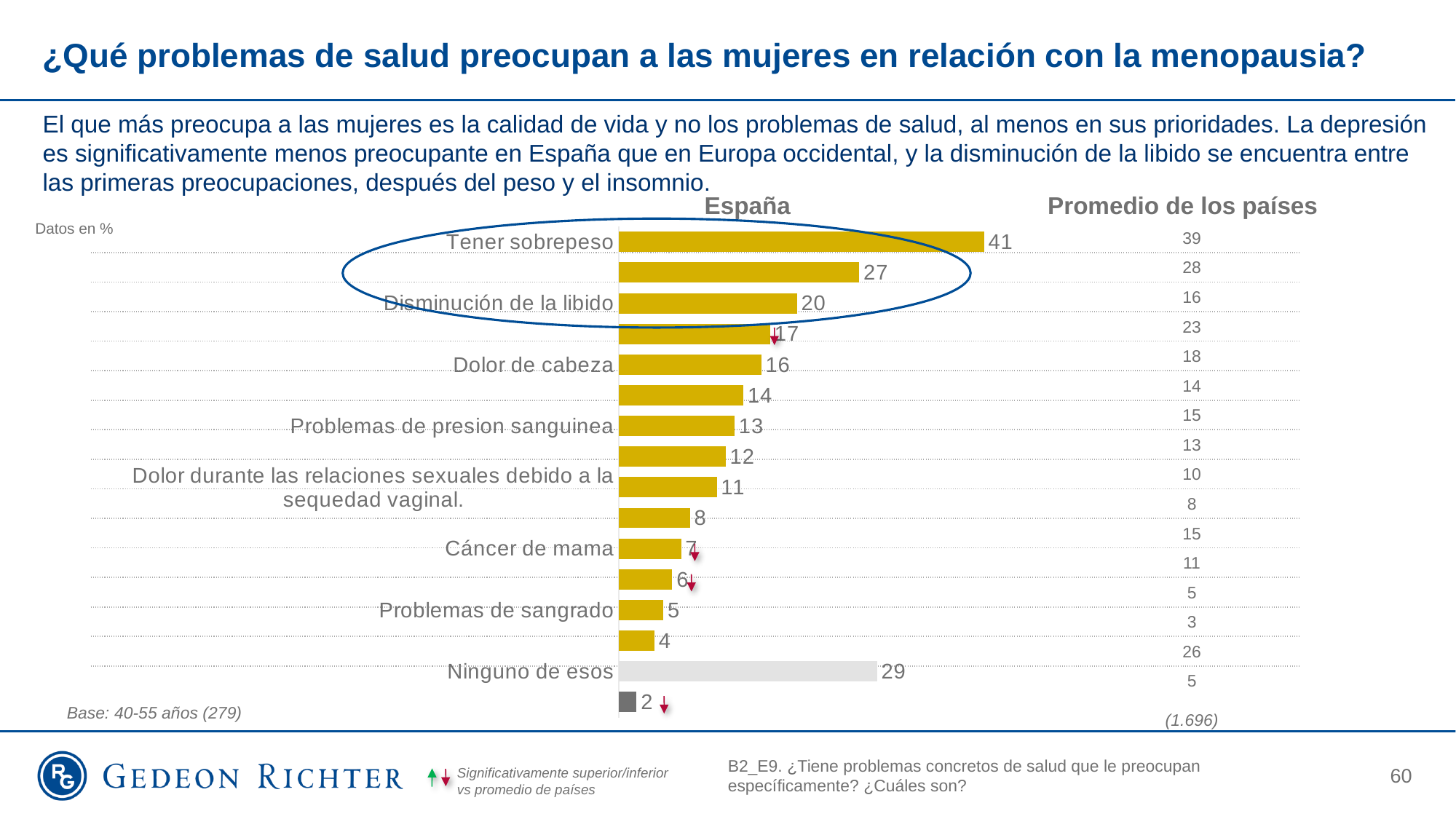
What is the value for Tener sobrepeso in the España bar chart? 41 What is the value for Ninguno de esos in the España bar chart? 29 What is the difference between the España values for Tener sobrepeso and Disminución de la libido? 21 What kind of chart is shown on the slide? Bar chart What is the value for Dolor de cabeza in the España bar chart? 16 What is the Promedio de los países value for Tener sobrepeso? 39 Which labelled health problem has the highest value in the España bar chart? Tener sobrepeso What is the value for Problemas de presion sanguinea in the España bar chart? 13 What is the value for Cáncer de mama in the España bar chart? 7 Which has a larger España value, Dolor de cabeza or Cáncer de mama? Dolor de cabeza What is the value for Disminución de la libido in the España bar chart? 20 What is the value for Problemas de sangrado in the España bar chart? 5